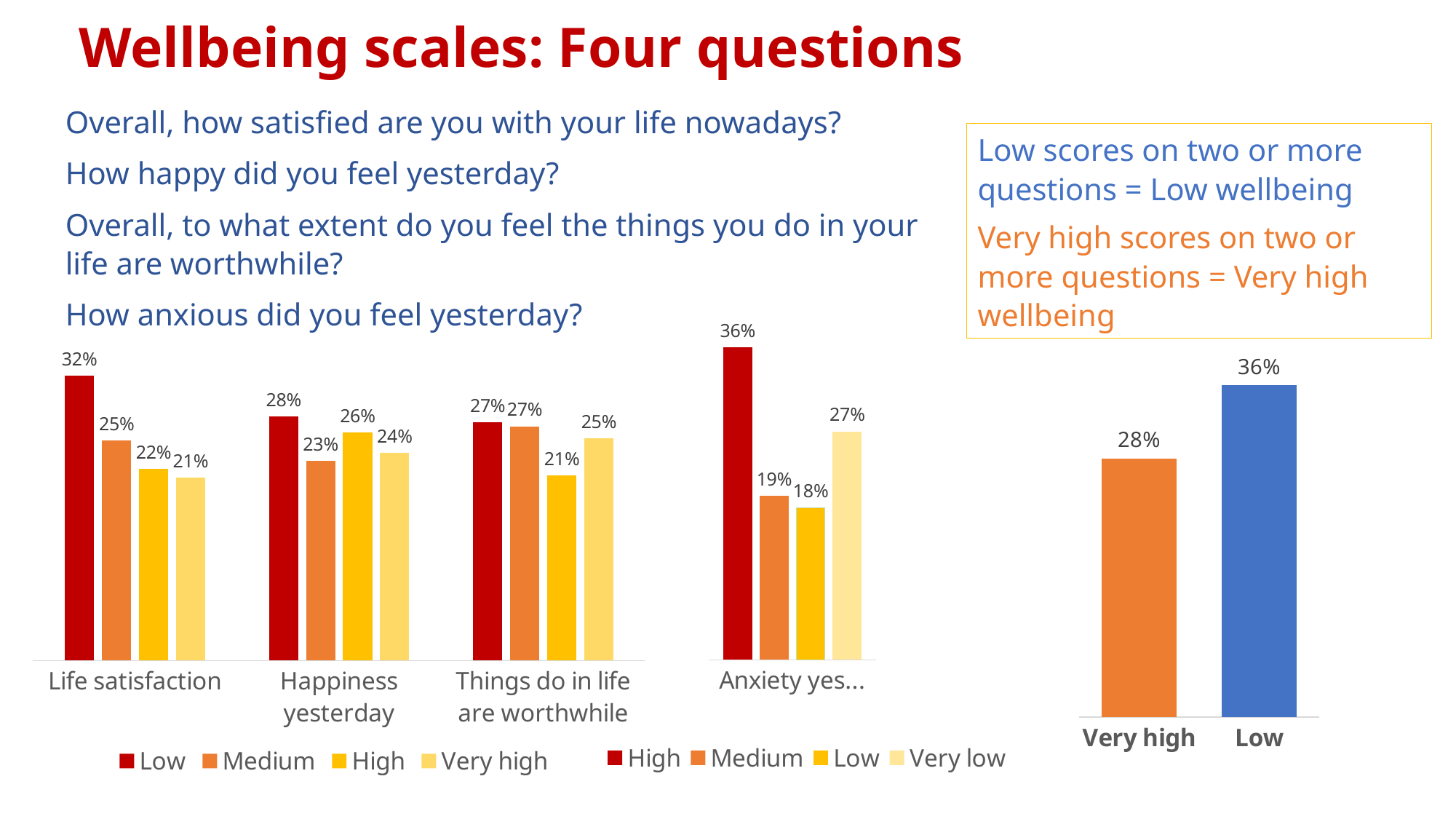
In the middle chart (Anxiety yesterday), which series has the lowest value? Low In the left chart, what is the value for High in the Happiness yesterday category? 26% What kind of chart is the right chart with the Very high and Low bars? bar chart In the middle chart (Anxiety yesterday), what is the value for High? 36% In the left chart, what is the value for Low in the Life satisfaction category? 32% In the left chart, what is the value for Very high in the Things do in life are worthwhile category? 25% In the left chart, what is the difference between the Low and Very high values for Life satisfaction? 11% In the right chart, what is the value for Low? 36% In the left chart, how many categories are shown on the x axis? 3 In the left chart, which series has the highest value in the Life satisfaction category? Low In the left chart, how many series does the legend list? 4 In the middle chart (Anxiety yesterday), is the value for Medium larger or smaller than the value for Very low? smaller